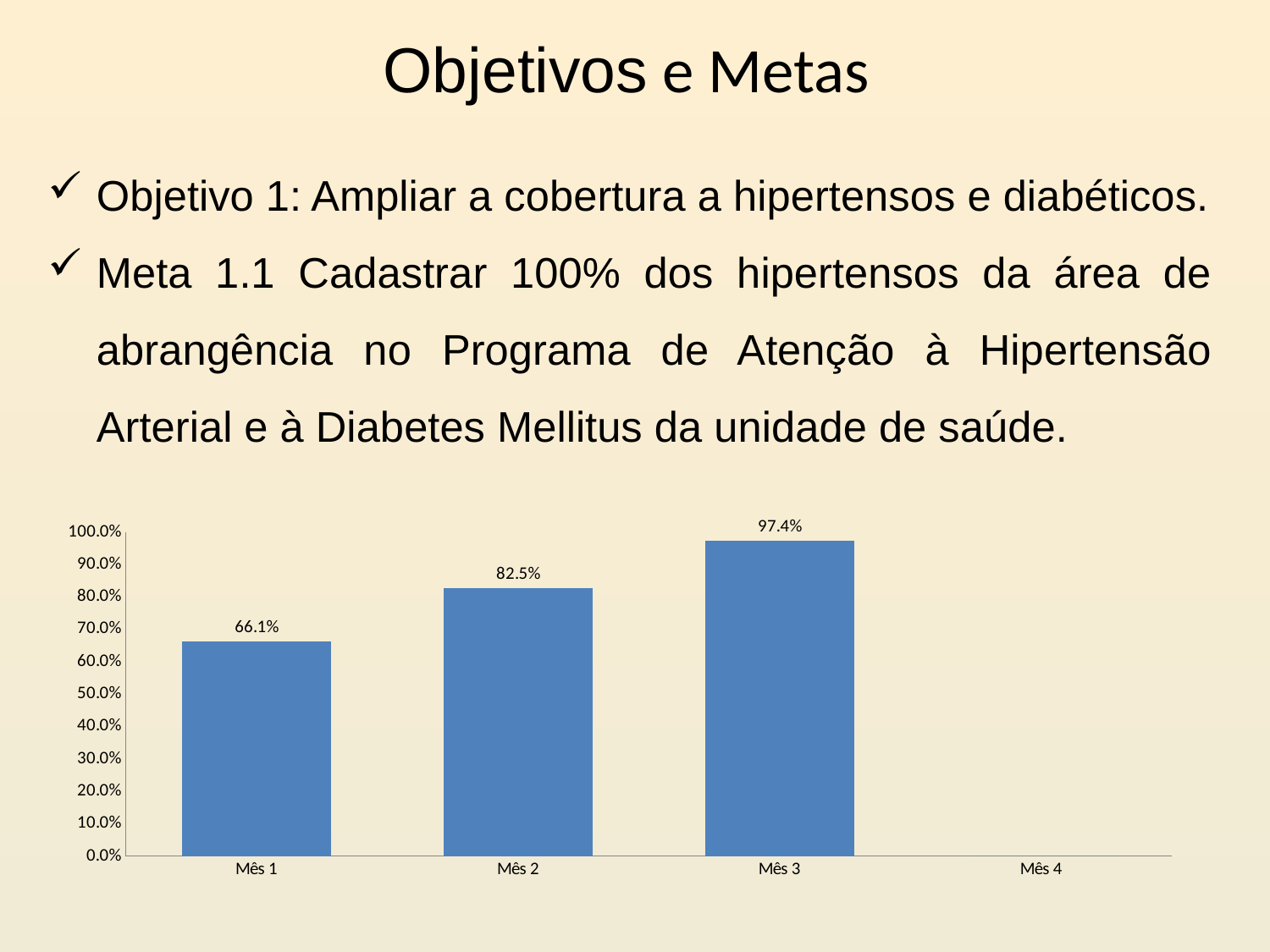
Do the values rise or fall from Mês 1 to Mês 3? rise What is the difference between the values for Mês 2 and Mês 1? 16.4% Which month has the highest value? Mês 3 What kind of chart is shown on the slide? bar chart Is the value for Mês 2 greater or less than 80.0%? greater What is the value for Mês 3? 97.4% How many categories are shown on the x axis? 4 What is the value for Mês 2? 82.5% What is the difference between the values for Mês 3 and Mês 1? 31.3% Among the months with a bar shown, which has the lowest value? Mês 1 Which is larger, the value for Mês 2 or the value for Mês 3? Mês 3 What is the value for Mês 1? 66.1%